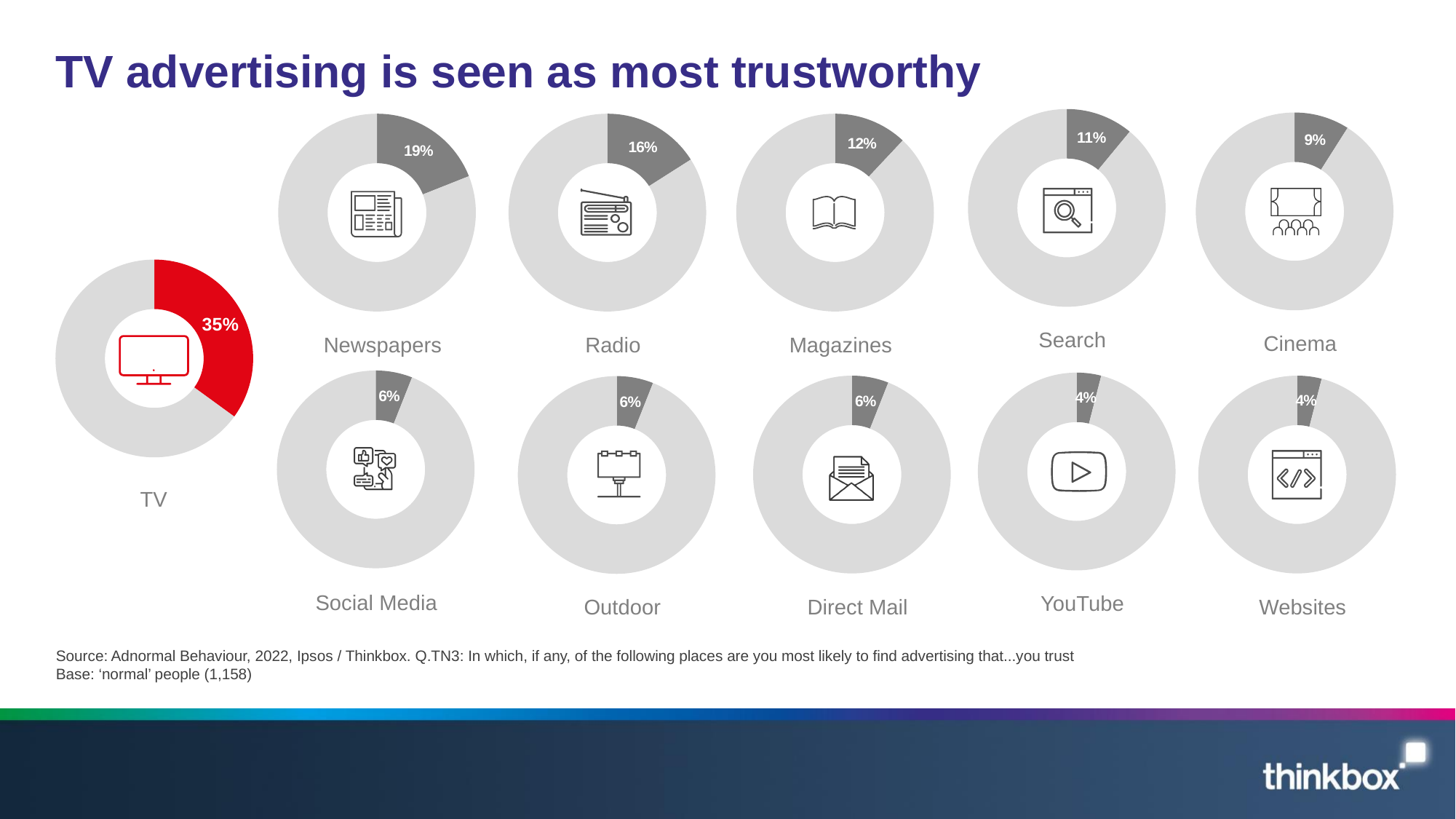
What percentage is shown for Radio? 16% What kind of chart is used for each medium on the slide? Donut (pie) chart Which has a higher percentage, Cinema or YouTube? Cinema Which medium's chart is highlighted in red? TV Which medium has the highest percentage on the slide? TV What percentage is shown for Cinema? 9% What is the difference in percentage points between TV and Newspapers? 16 How many media categories are shown on the slide? 11 What is the difference in percentage points between Magazines and Search? 1 Which has a higher percentage, Radio or Magazines? Radio What percentage is shown for TV? 35% What percentage is shown for Newspapers? 19%